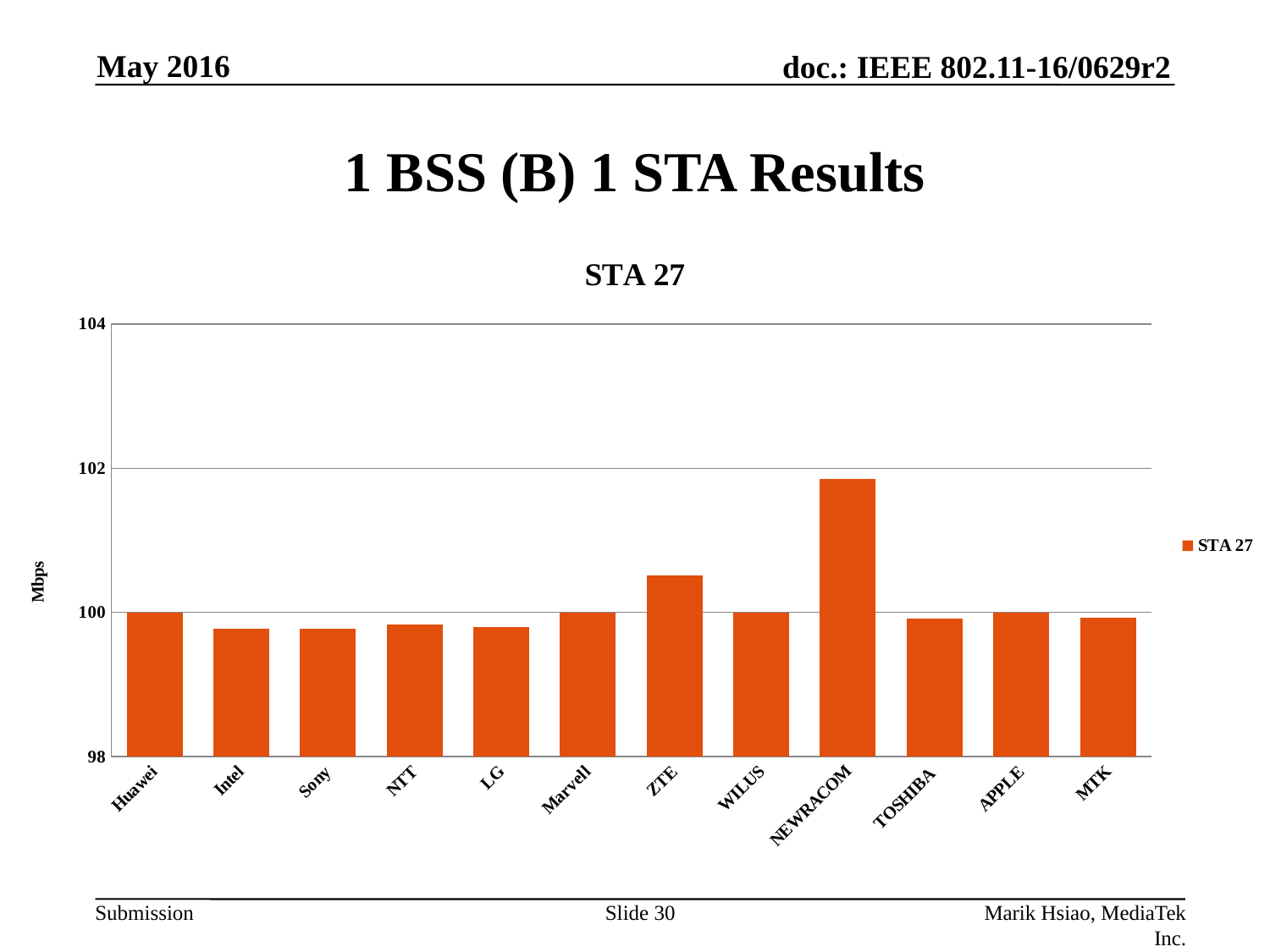
What is the title of the chart? STA 27 How many companies are shown on the x axis of the chart? 12 Which is larger, the value for NEWRACOM or the value for ZTE? NEWRACOM What kind of chart is shown on the slide? bar chart Is the value for ZTE greater or less than 100? greater Which is larger, the value for ZTE or the value for Sony? ZTE Which company has the highest value in the chart? NEWRACOM Is the value for Intel greater or less than 100? less Is the value for NEWRACOM greater or less than 100? greater How many series does the legend list? 1 What unit is shown on the y axis label of the chart? Mbps